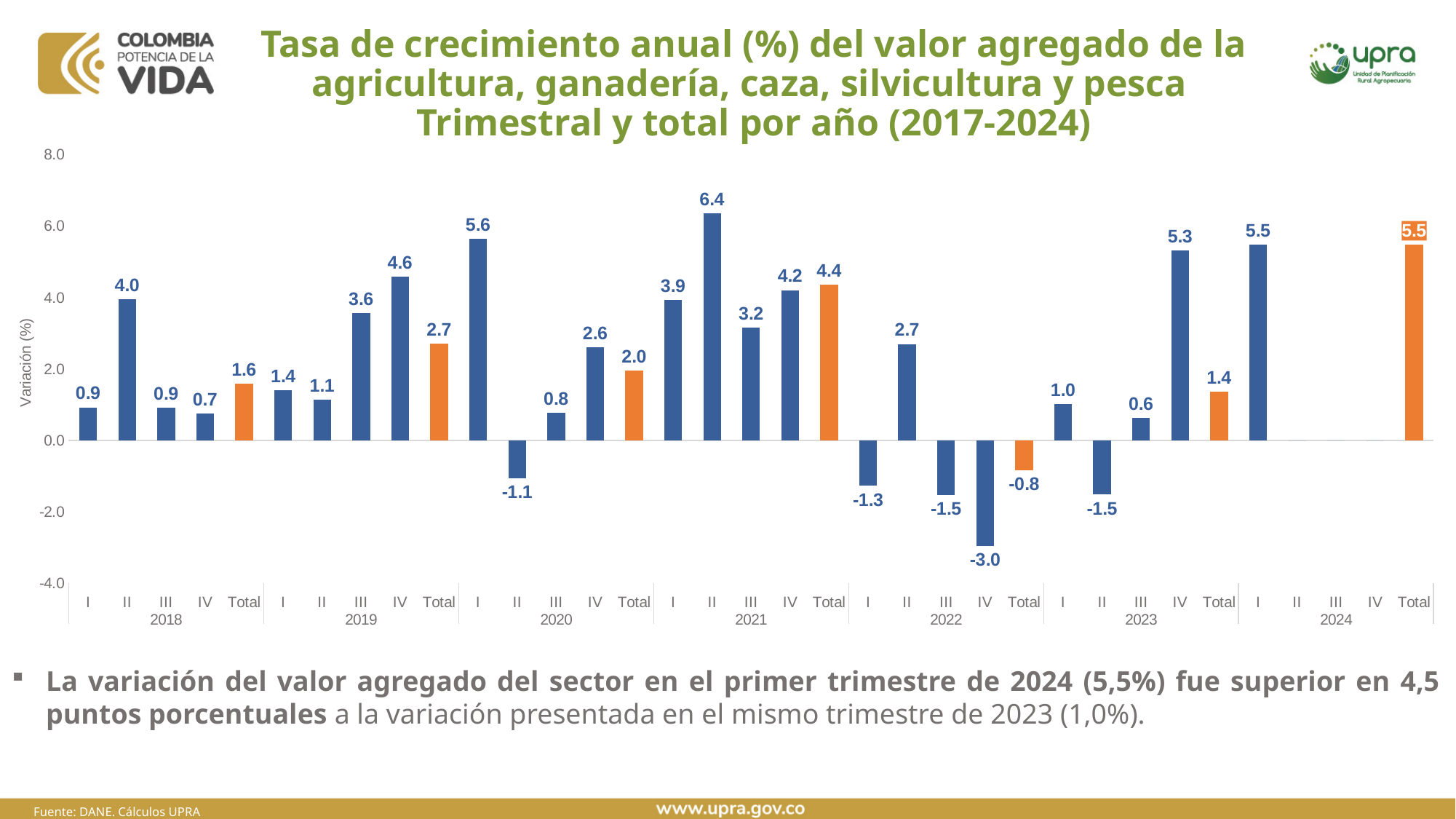
Which quarter-year bar has the highest value on the chart? II 2021 What colour are the annual 'Total' bars on the chart? Orange What is the total annual growth rate shown for 2022? -0.8 Which is larger: the annual total for 2019 or the annual total for 2023? 2019 What is the annual growth rate for quarter II of 2021? 6.4 Which quarter-year bar has the lowest value on the chart? IV 2022 What is the difference between the annual totals for 2021 and 2020? 2.4 Is the value for quarter I of 2020 greater or less than 4.0? greater By how many percentage points does the value for quarter I of 2024 exceed the value for quarter I of 2023? 4.5 How many annual 'Total' bars are shown on the chart? 7 What kind of chart is shown on the slide? Bar chart What is the growth rate for quarter IV of 2023? 5.3